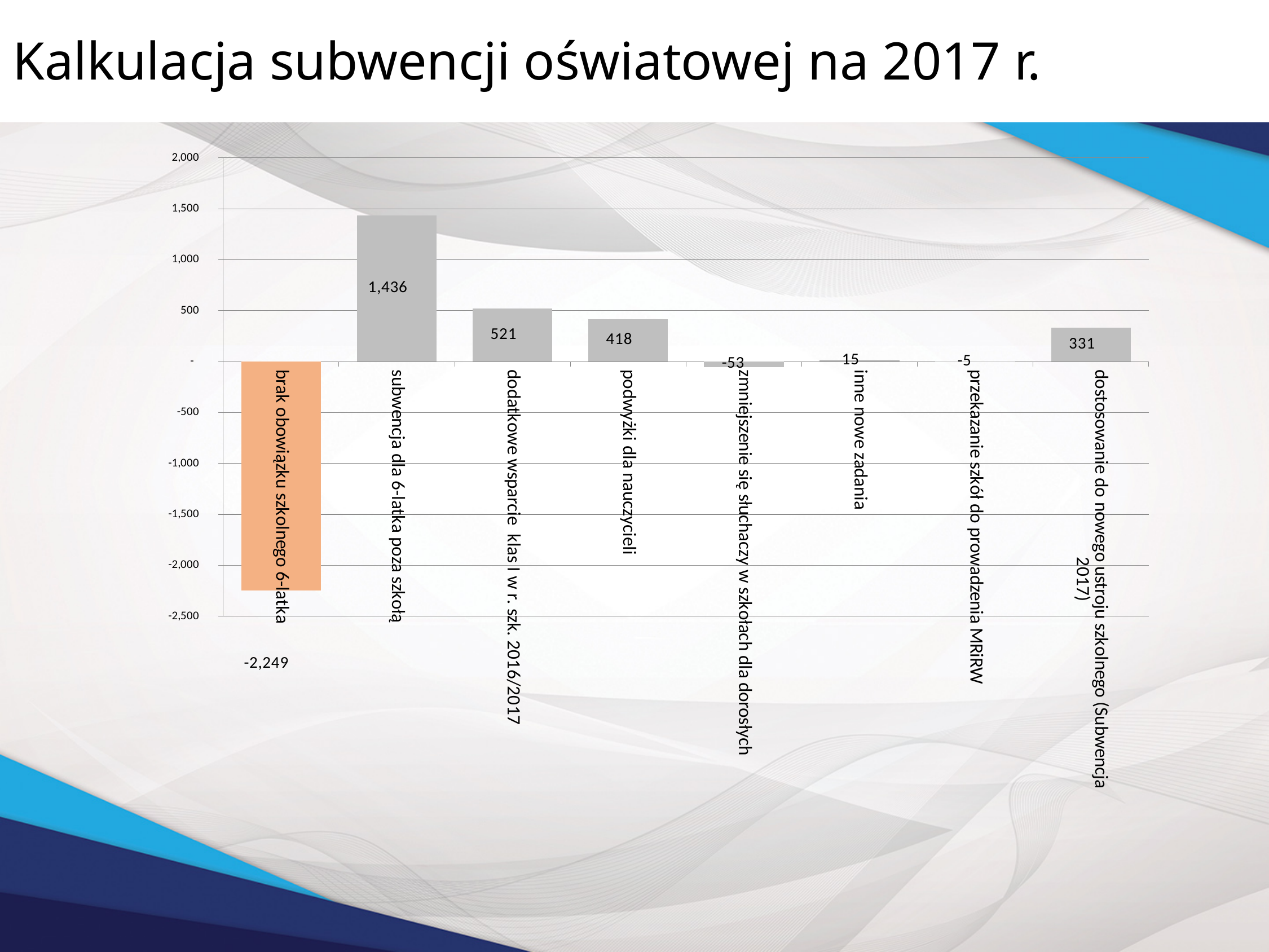
What is the value for "subwencja dla 6-latka poza szkołą"? 1,436 What kind of chart is shown on the slide? bar chart Which category has the lowest value? brak obowiązku szkolnego 6-latka What is the value for "przekazanie szkół do prowadzenia MRiRW"? -5 Which is larger, the value for "inne nowe zadania" or the value for "zmniejszenie się słuchaczy w szkołach dla dorosłych"? inne nowe zadania What is the value for "dostosowanie do nowego ustroju szkolnego (Subwencja 2017)"? 331 What is the value for "brak obowiązku szkolnego 6-latka"? -2,249 How many categories are shown in the chart? 8 Which category has the highest value? subwencja dla 6-latka poza szkołą What is the value for "podwyżki dla nauczycieli"? 418 What is the difference between the values for "dodatkowe wsparcie klas I w r. szk. 2016/2017" and "podwyżki dla nauczycieli"? 103 What is the title of the slide? Kalkulacja subwencji oświatowej na 2017 r.